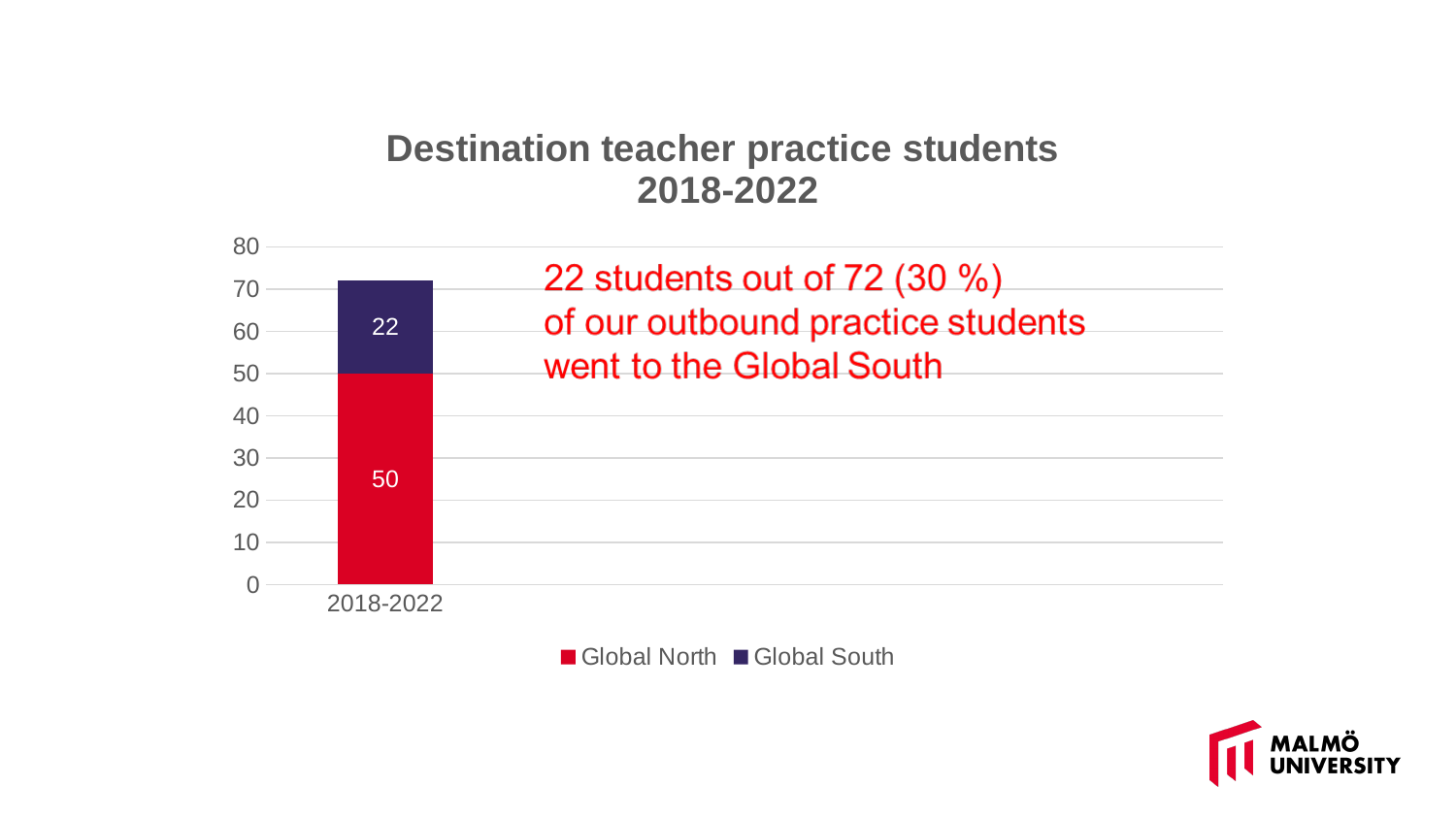
Which colour represents Global South in the chart? Dark purple What kind of chart is shown on the slide? Stacked bar chart What is the difference between the Global North and Global South values for 2018-2022? 28 What is the value for Global North in the 2018-2022 bar? 50 What is the value for Global South in the 2018-2022 bar? 22 Is the total height of the 2018-2022 bar greater or less than 70? greater Which series has the larger value in the 2018-2022 bar, Global North or Global South? Global North How many series does the legend list? 2 What is the total of the stacked bar for 2018-2022? 72 How many categories are shown on the x axis? 1 What is the title of the chart? Destination teacher practice students 2018-2022